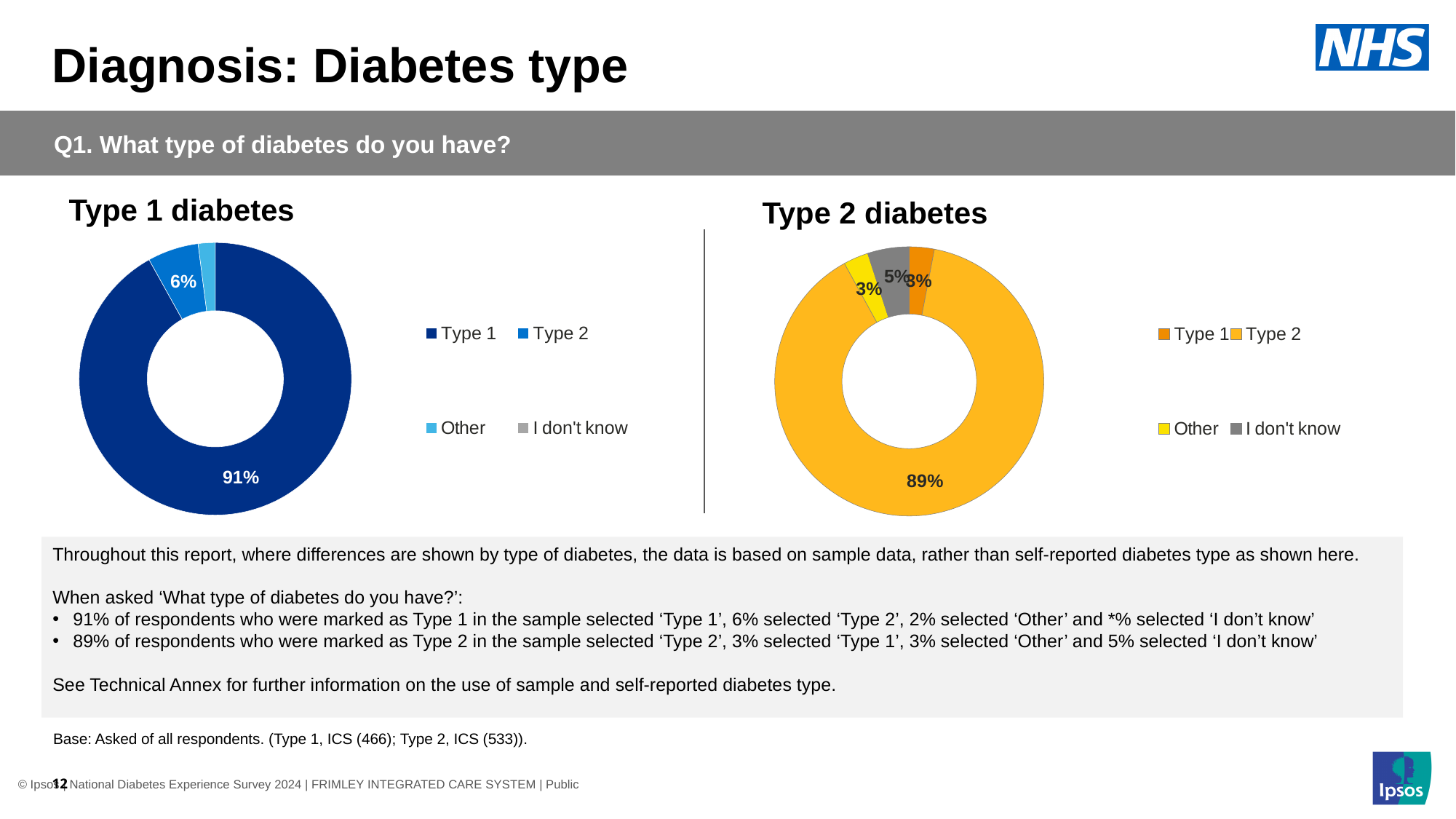
What kind of chart is used to show the Type 1 diabetes results? Pie (donut) chart How many categories does the legend of the Type 2 diabetes chart list? 4 In the Type 2 diabetes chart, which category has the largest share? Type 2 In the Type 2 diabetes chart, what percentage of respondents selected 'I don't know'? 5% In the Type 2 diabetes chart, what percentage of respondents selected 'Type 2'? 89% Which chart shows a larger share for its majority category: the Type 1 diabetes chart (Type 1) or the Type 2 diabetes chart (Type 2)? Type 1 diabetes chart In the Type 1 diabetes chart, what percentage of respondents selected 'Type 2'? 6% In the Type 2 diabetes chart, what colour represents the 'Other' category? Yellow In the Type 1 diabetes chart, what is the difference in percentage points between the 'Type 1' and 'Type 2' shares? 85 percentage points In the Type 2 diabetes chart, which is larger: the share for 'Type 2' or the share for 'I don't know'? Type 2 In the Type 1 diabetes chart, which category has the largest share? Type 1 In the Type 1 diabetes chart, what percentage of respondents selected 'Type 1'? 91%